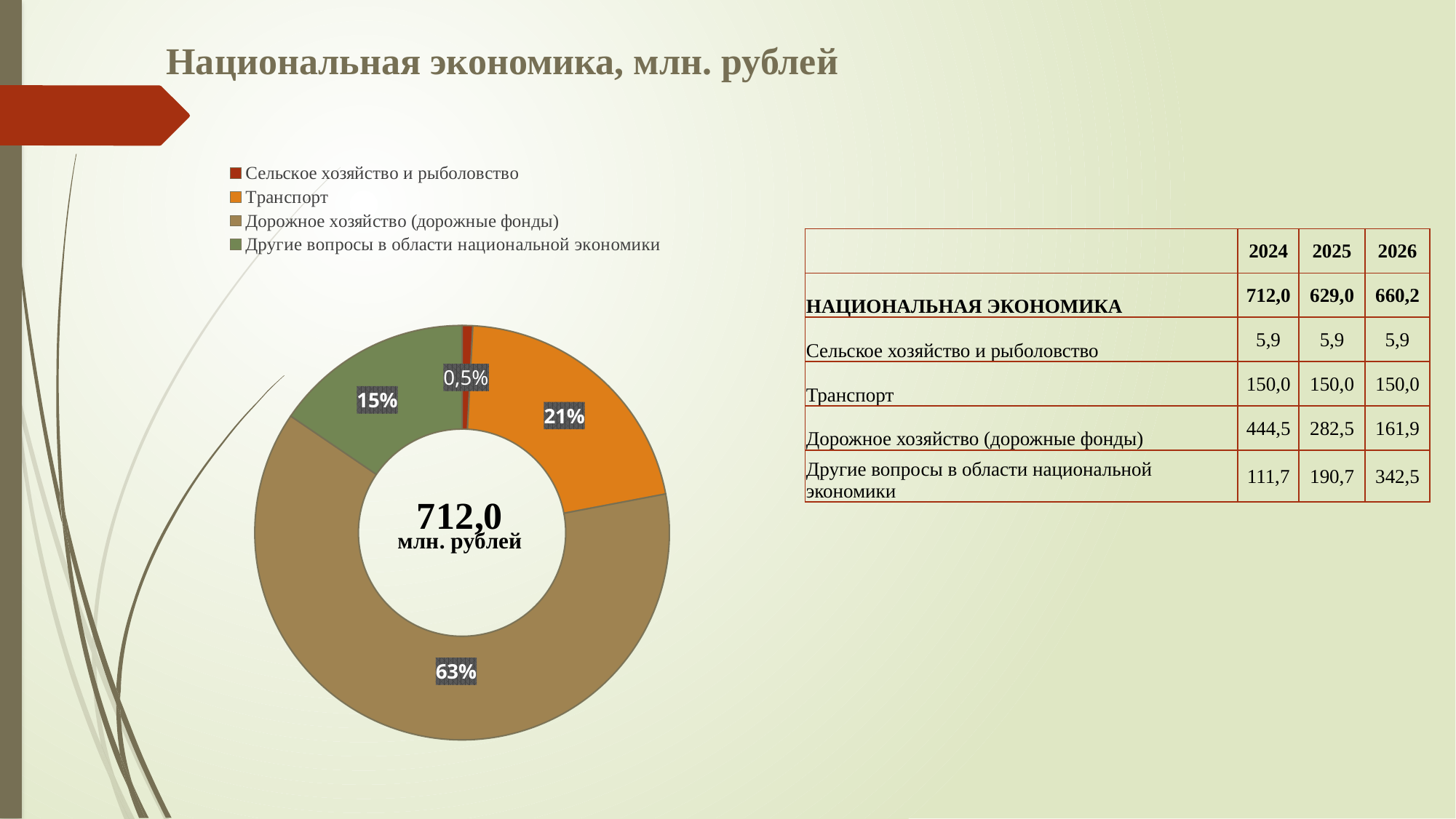
Which category has the smallest slice in the doughnut chart? Сельское хозяйство и рыболовство Which category has the largest slice in the doughnut chart? Дорожное хозяйство (дорожные фонды) What colour is the Транспорт slice in the doughnut chart? Orange What total value is printed in the centre of the doughnut chart? 712,0 млн. рублей What share of the doughnut chart does Транспорт account for? 21% What kind of chart is shown on the slide? Doughnut (pie) chart How many categories does the legend of the doughnut chart list? 4 What share of the doughnut chart does Сельское хозяйство и рыболовство account for? 0,5% What share of the doughnut chart does Другие вопросы в области национальной экономики account for? 15% Which slice is larger in the doughnut chart: Транспорт or Другие вопросы в области национальной экономики? Транспорт What is the difference in percentage points between the Дорожное хозяйство (дорожные фонды) slice and the Транспорт slice? 42